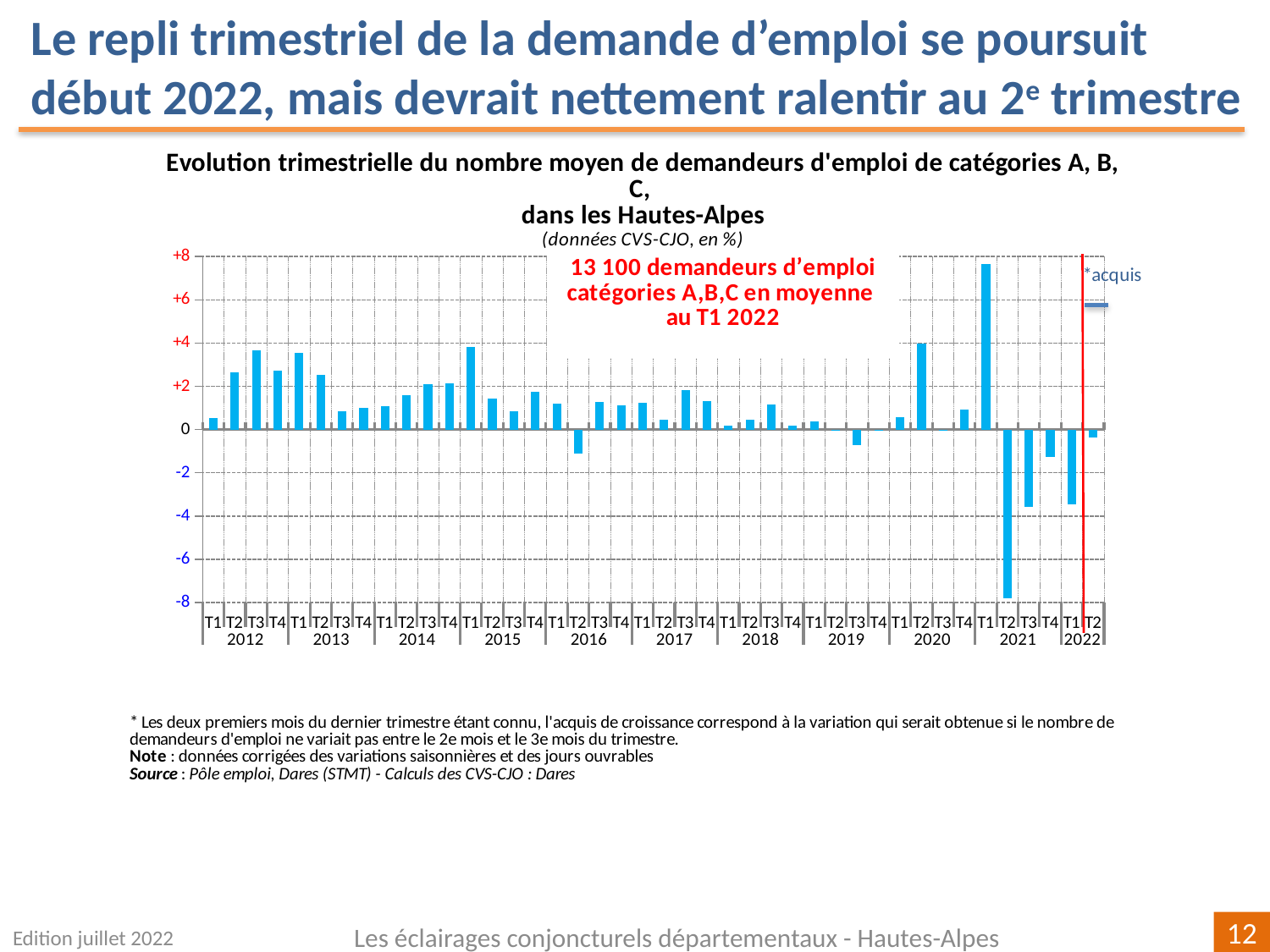
Is the value for T1 2012 greater or less than +2? less Which is larger, the value for T3 2012 or the value for T1 2012? T3 2012 Is the value for T1 2015 greater or less than +2? greater How many quarterly bars are plotted on the chart? 42 Is the value for T1 2021 greater or less than +6? greater According to the red annotation on the chart, how many demandeurs d'emploi catégories A,B,C were there on average in T1 2022? 13 100 What kind of chart is shown on the slide? bar chart Which quarter has the lowest value on the chart? T2 2021 Which is larger, the value for T1 2021 or the value for T2 2020? T1 2021 Which quarter has the highest value on the chart? T1 2021